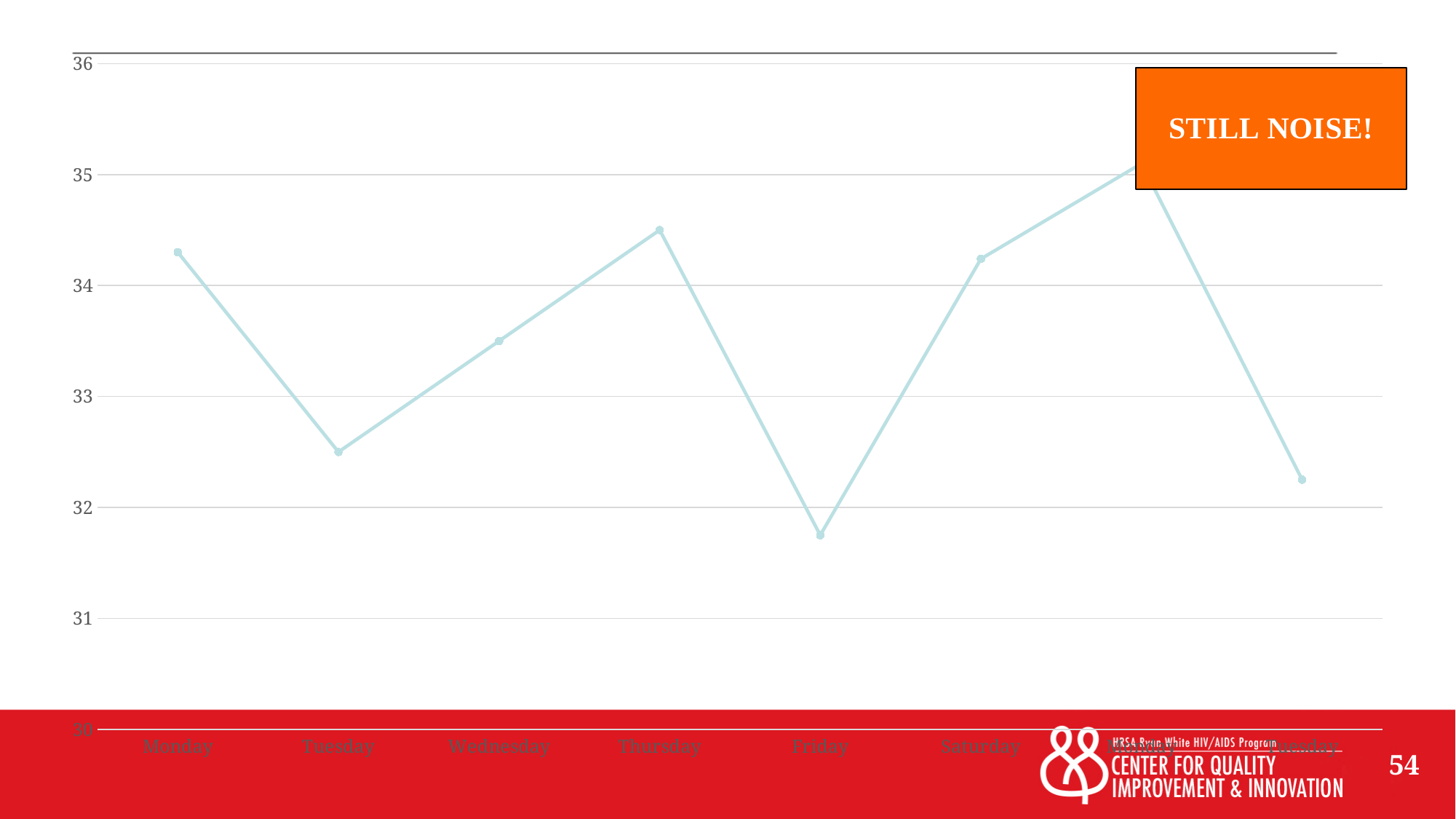
Does the line rise or fall from the first Tuesday to Thursday? rise Is the value for the first Monday greater or less than 34? greater Is the value for the last point (the second Tuesday) greater or less than 33? less What text is shown in the orange box on the chart? STILL NOISE! Is the value for the first Tuesday greater or less than 33? less What kind of chart is shown on the slide? line chart Which is higher, the value for Wednesday or the value for Thursday? Thursday Which day has the lowest value on the chart? Friday Which is higher, the value for Friday or the value for Saturday? Saturday How many data points are plotted on the line? 8